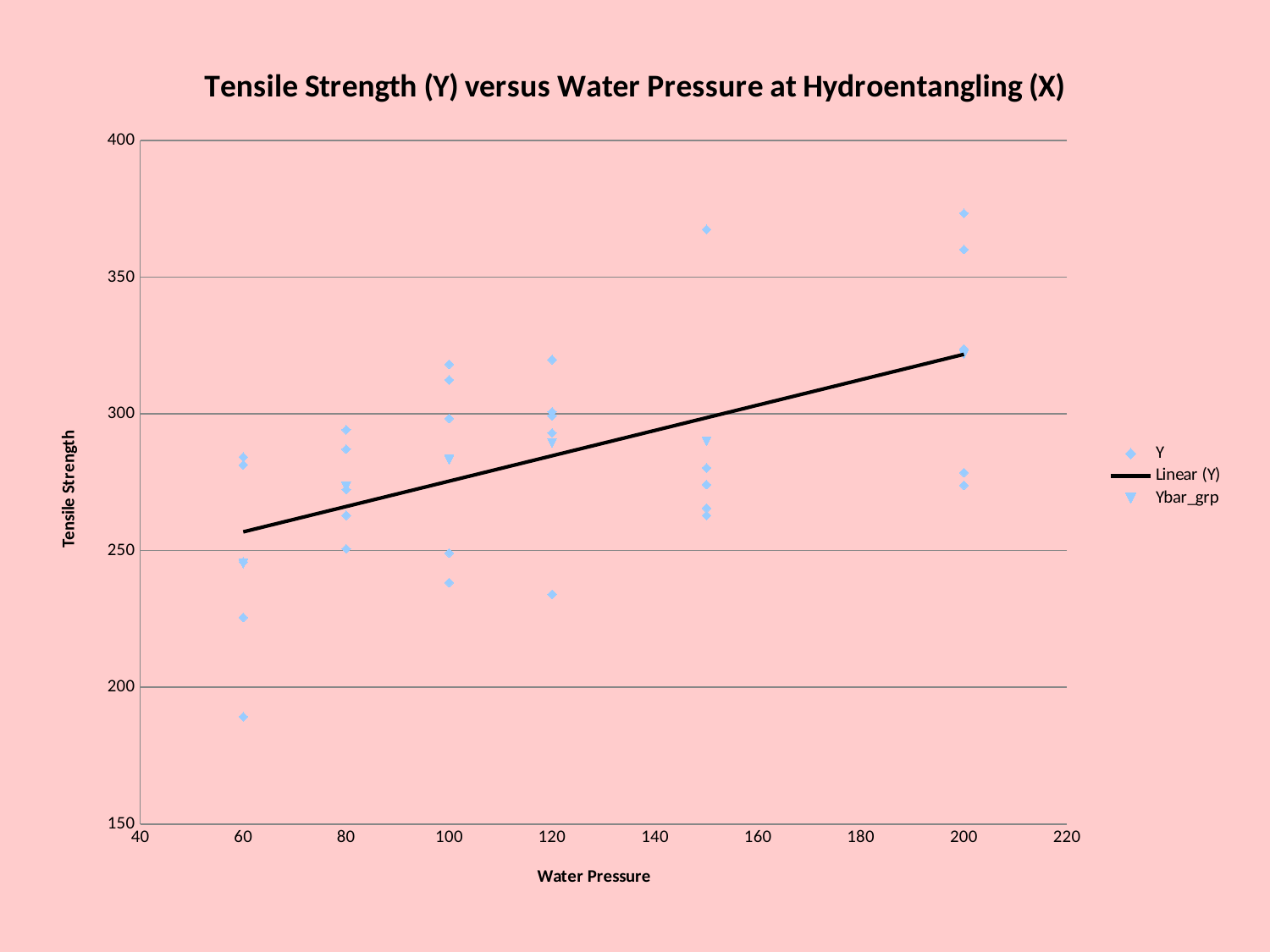
At which Water Pressure level does the lowest Y data point occur? 60 Is the Ybar_grp value at Water Pressure 100 greater or less than 300? less Is the Ybar_grp value at Water Pressure 200 greater or less than 300? greater How many distinct Water Pressure levels have data points plotted? 6 Is the Ybar_grp value at Water Pressure 80 greater or less than 250? greater What is the title of the chart? Tensile Strength (Y) versus Water Pressure at Hydroentangling (X) How many entries does the chart legend list? 3 What is the label of the x axis? Water Pressure Is the Ybar_grp value at Water Pressure 200 larger or smaller than the Ybar_grp value at Water Pressure 60? larger Does the Linear (Y) trend line rise or fall as Water Pressure increases? rises What kind of chart is shown on the slide? scatter chart